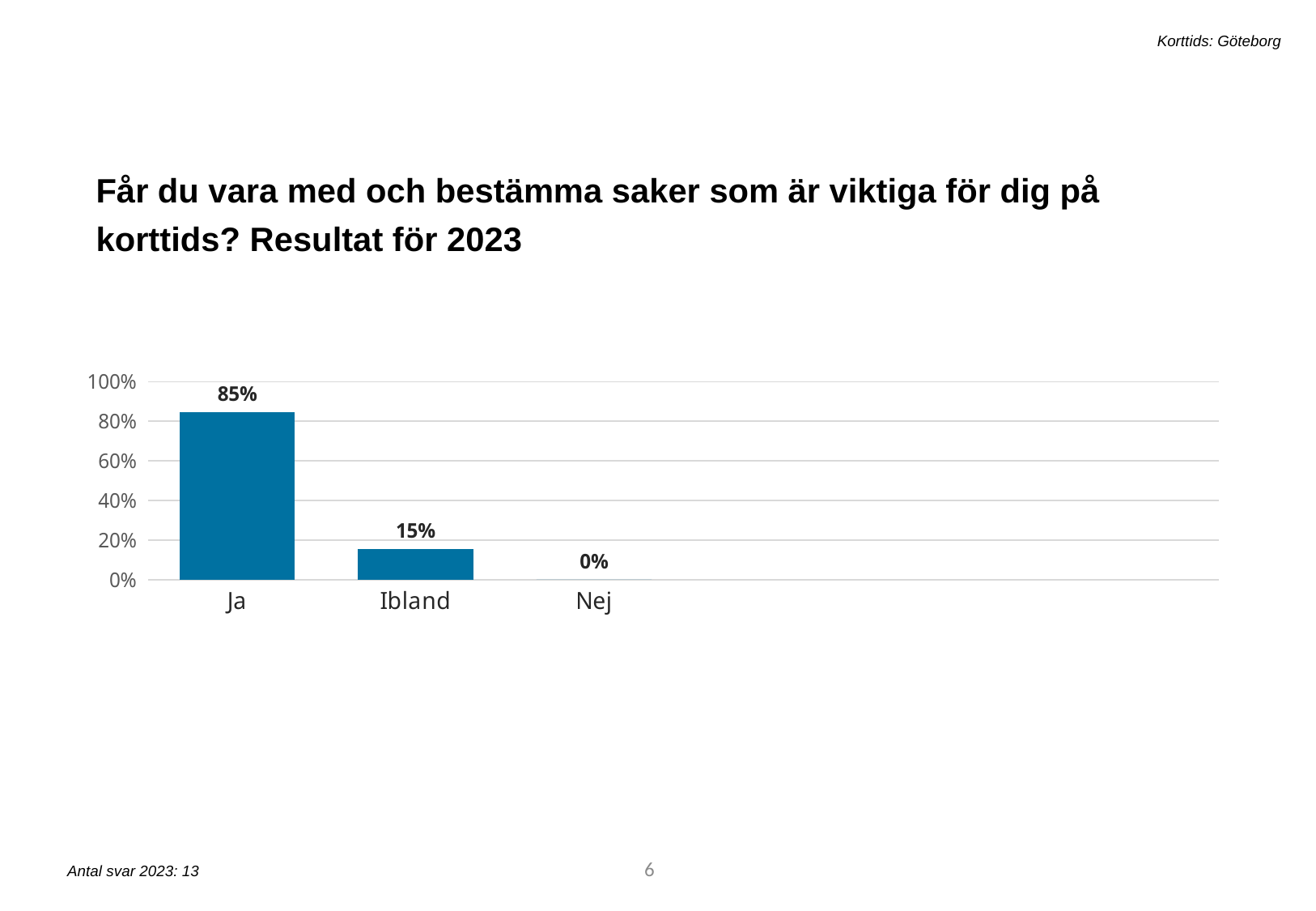
Is the value for Ja greater or less than 60%? greater What kind of chart is shown on the slide? bar chart How many categories are shown on the x axis? 3 What is the value for Ja? 85% Do the values rise or fall from left to right along the x axis? fall Which category has the highest value? Ja What is the value for Ibland? 15% Which is larger, the value for Ibland or the value for Nej? Ibland Which category has the lowest value? Nej What is the difference between the values for Ja and Ibland? 70% What is the value for Nej? 0% What is the highest value shown on the y axis? 100%